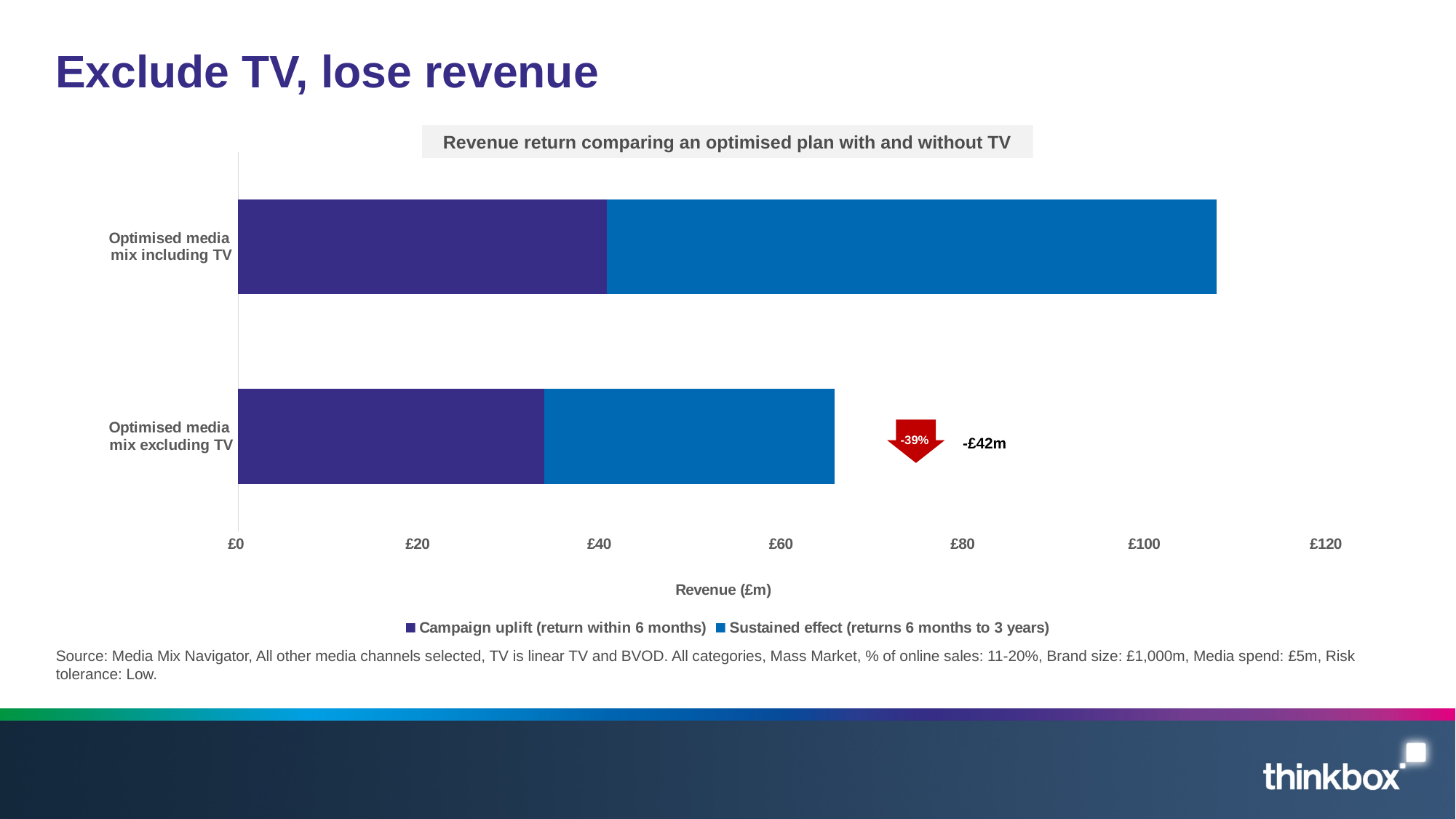
What is the title of the chart? Revenue return comparing an optimised plan with and without TV Which category has the lower total revenue return? Optimised media mix excluding TV How many categories are plotted on the chart? 2 Is the total revenue return for the optimised media mix excluding TV greater or less than £80? less What percentage change is shown in the red arrow annotation next to the excluding TV bar? -39% Is the campaign uplift value for the optimised media mix excluding TV greater or less than £40? less What kind of chart is shown on the slide? Stacked bar chart For the optimised media mix including TV, which is larger: the campaign uplift or the sustained effect? Sustained effect How many series does the legend list? 2 What is the label of the horizontal axis? Revenue (£m) Which category has the higher total revenue return? Optimised media mix including TV Is the total revenue return for the optimised media mix including TV greater or less than £100? greater